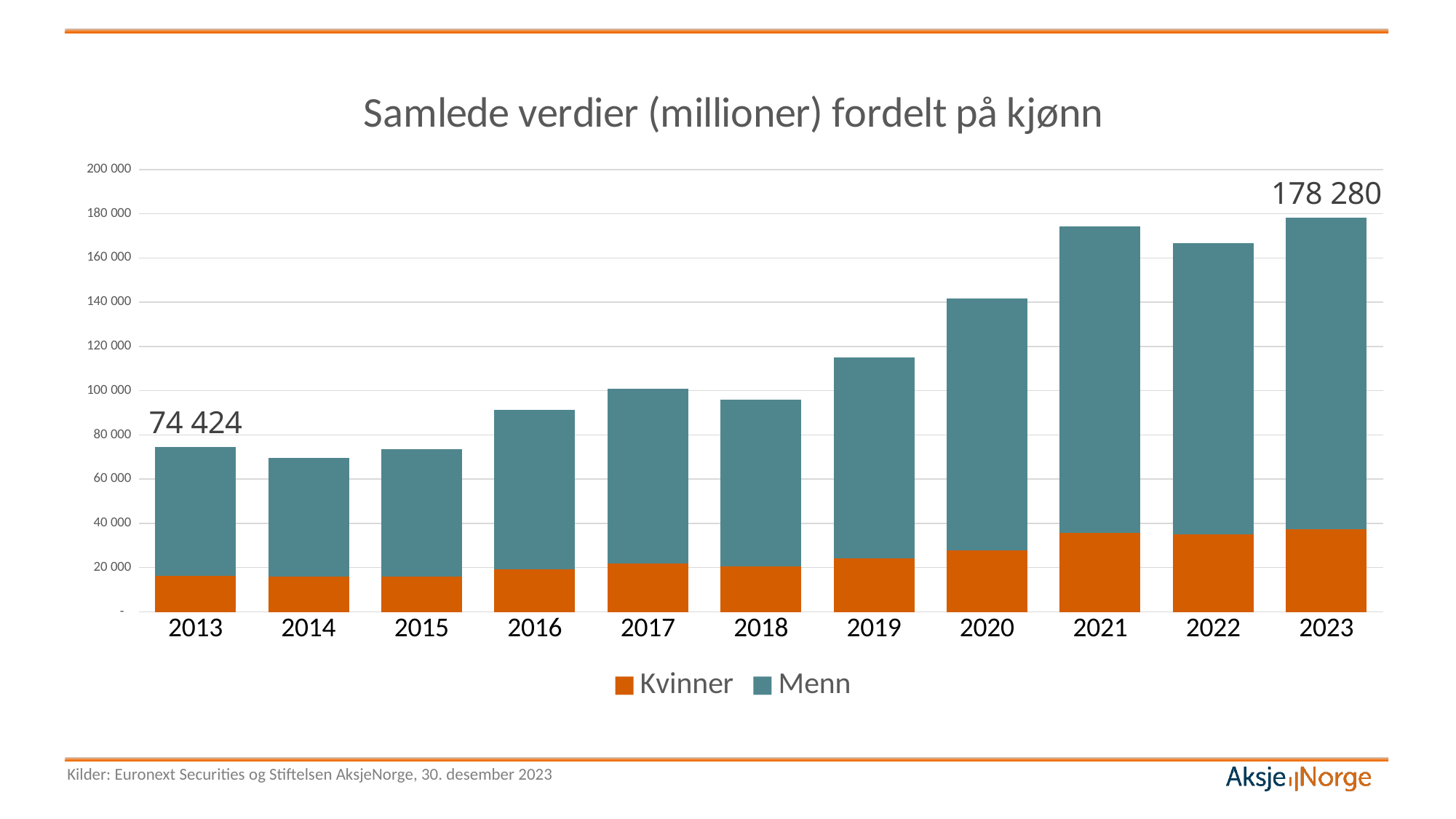
How many series does the legend list? 2 What is the total value labelled for 2013? 74 424 Is the total value for 2021 greater or less than 160 000? greater Which year has the lowest total value? 2014 What is the total value labelled for 2023? 178 280 What is the title of the chart? Samlede verdier (millioner) fordelt på kjønn What kind of chart is shown on the slide? bar chart Which is larger in 2023, the Kvinner segment or the Menn segment? Menn How many years are shown on the x axis? 11 What is the difference between the labelled totals for 2023 and 2013? 103 856 Is the total value for 2019 greater or less than 120 000? less Which year has the highest total value? 2023